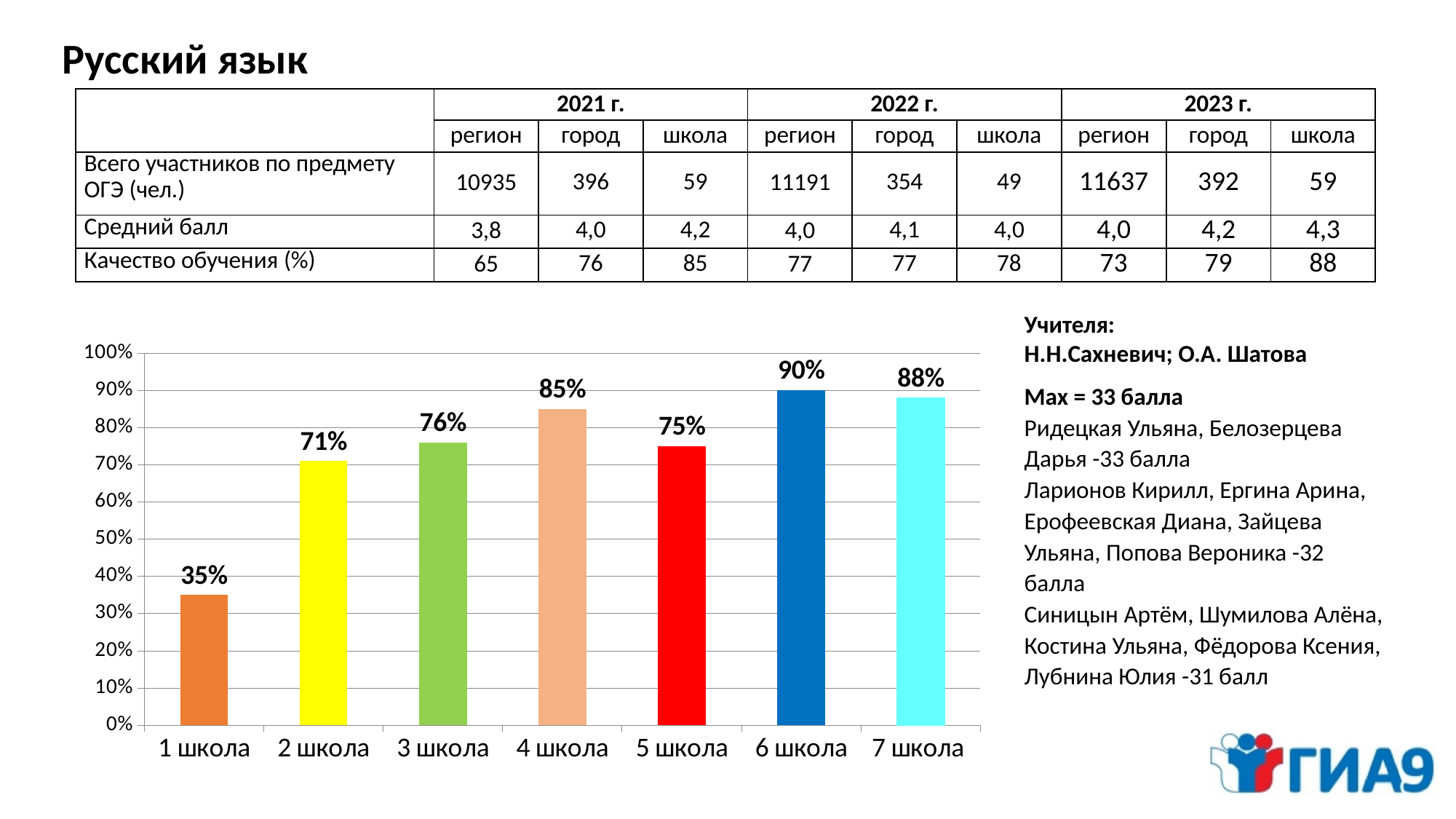
What is the value for 1 школа in the bar chart? 35% What is the value for 7 школа in the bar chart? 88% What kind of chart is shown on the slide? bar chart What is the difference between the values for 3 школа and 2 школа? 5% What colour is the bar for 5 школа? red Which is larger, the value for 4 школа or the value for 5 школа? 4 школа Which school has the lowest value in the bar chart? 1 школа Which school has the highest value in the bar chart? 6 школа What is the difference between the values for 6 школа and 1 школа? 55% How many schools are shown in the bar chart? 7 What is the value for 4 школа in the bar chart? 85% Is the value for 2 школа greater or less than 60%? greater